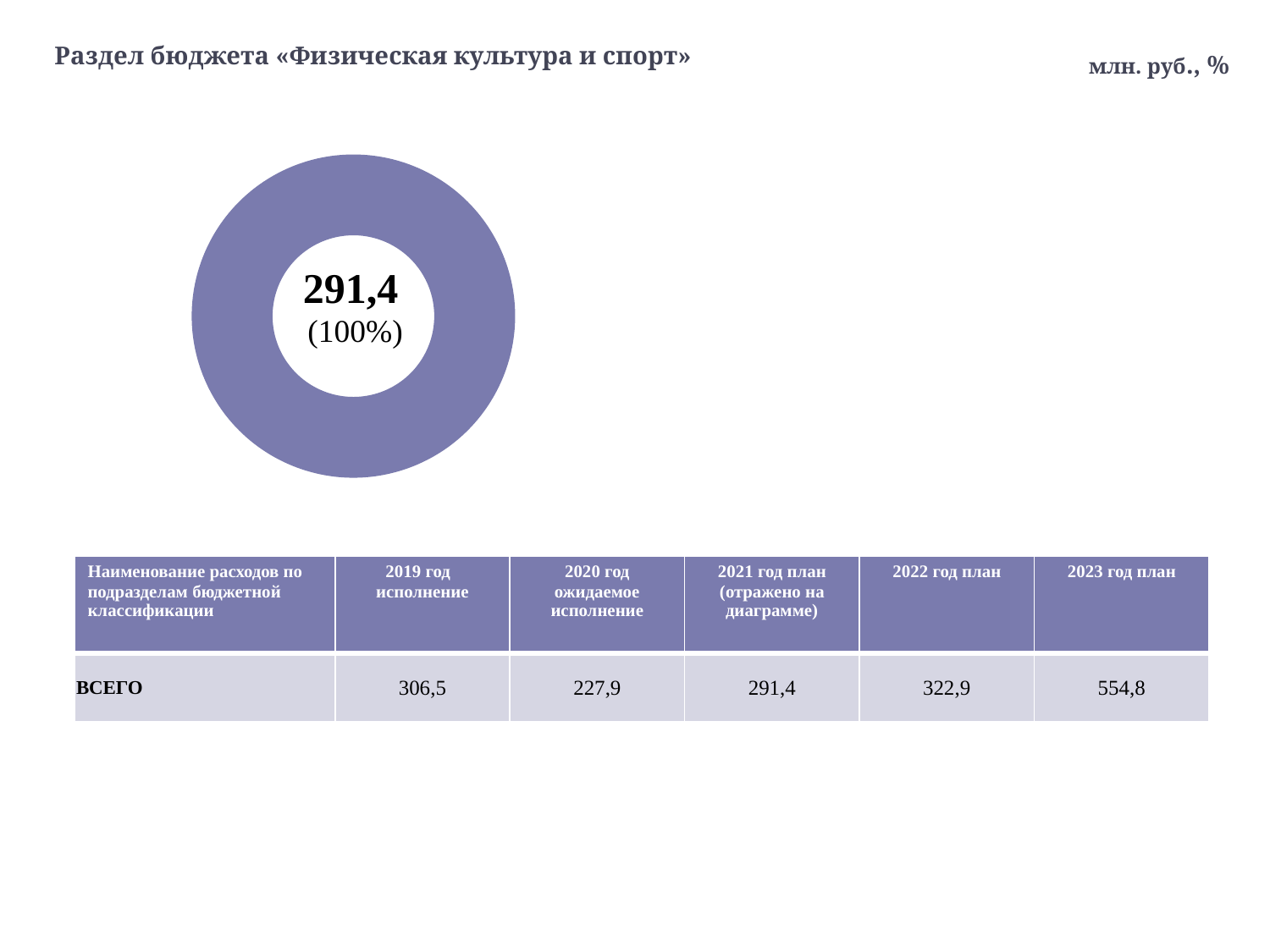
Is the value shown on the doughnut chart greater or less than 300? less How many slices does the doughnut chart contain? 1 What kind of chart is shown on the slide? doughnut chart What colour is the slice of the doughnut chart? purple What value is printed in the centre of the doughnut chart? 291,4 What share of the doughnut chart does the single slice represent? 100%